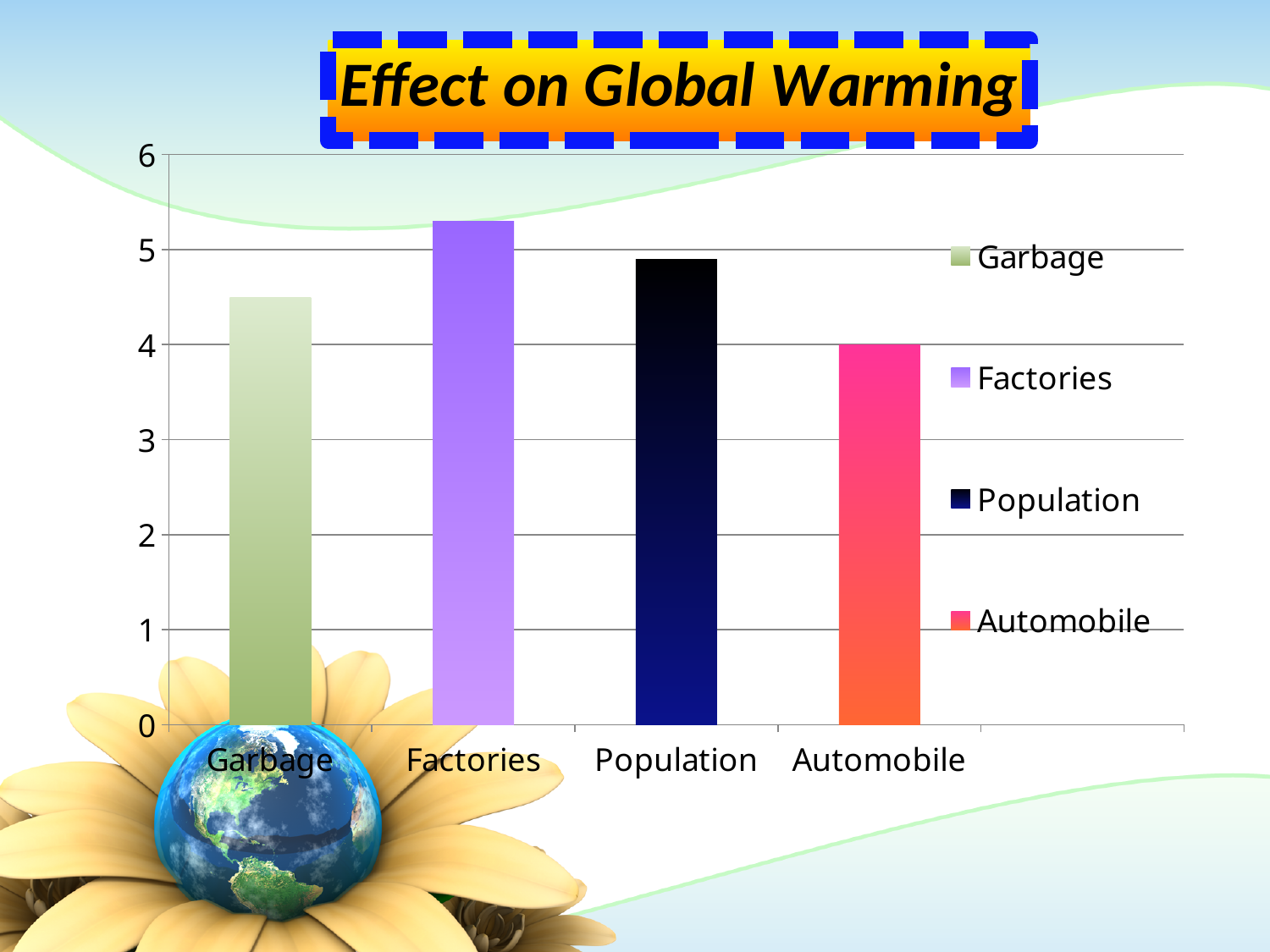
Which category has the highest bar? Factories Which category has the lowest bar? Automobile Which is larger, the value for Population or the value for Automobile? Population How many entries does the chart's legend list? 4 Is the value for Factories greater or less than 5? greater Is the value for Garbage greater or less than 5? less What kind of chart is shown on the slide? bar chart Which is larger, the value for Factories or the value for Garbage? Factories How many categories are shown on the x axis of the chart? 4 What is the title of the chart? Effect on Global Warming What is the value for Automobile? 4 Is the value for Population greater or less than 4? greater